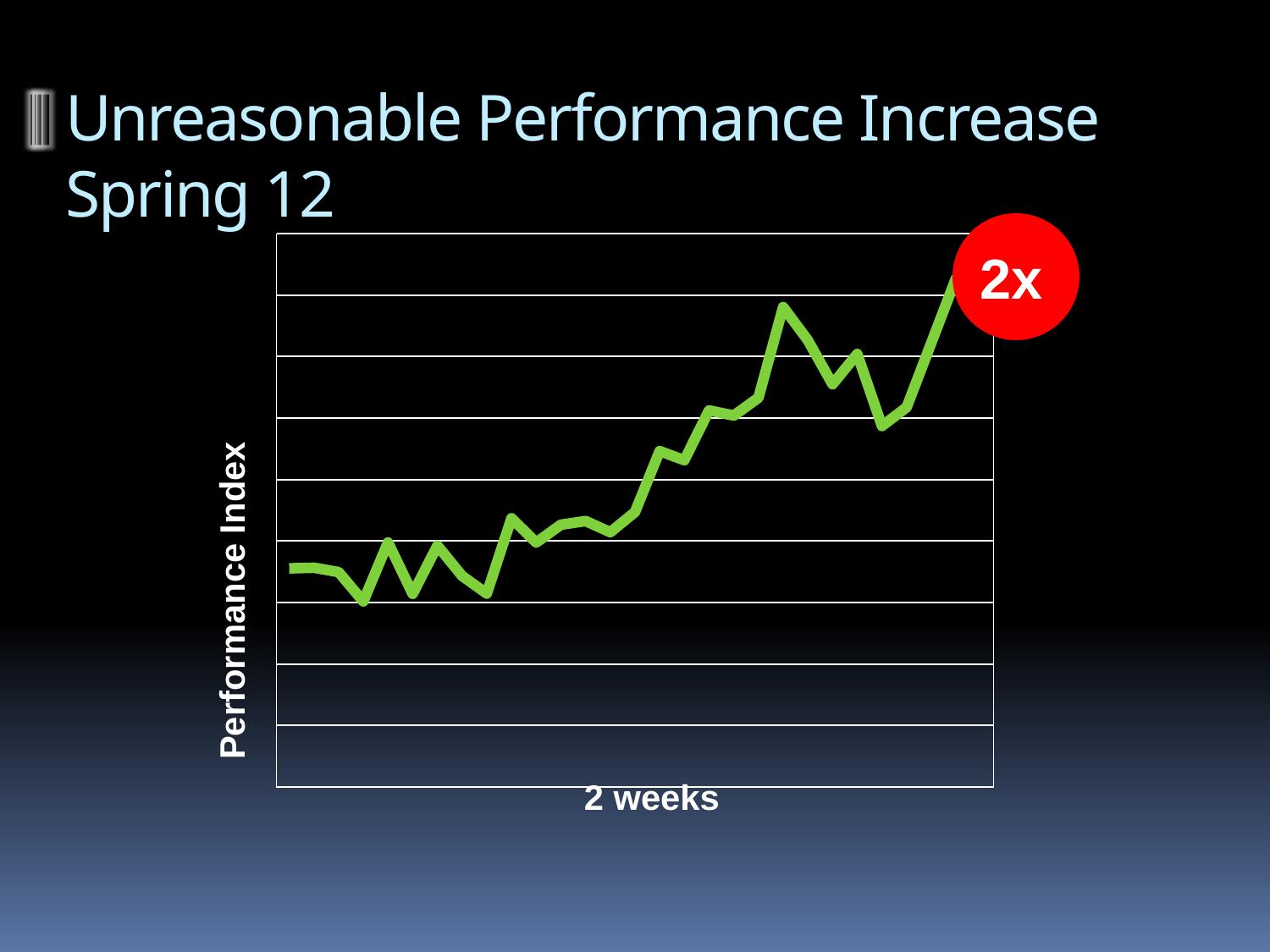
At which end of the x axis does the line reach its highest value? The right end Does the Performance Index line generally rise or fall from left to right along the x axis? Rise What is the title of the vertical axis? Performance Index How many lines are plotted on the chart? 1 What label is shown in the red circle at the top right of the chart? 2x What kind of chart is shown on the slide? Line chart Is the value at the right end of the line higher or lower than the value at the left end? Higher